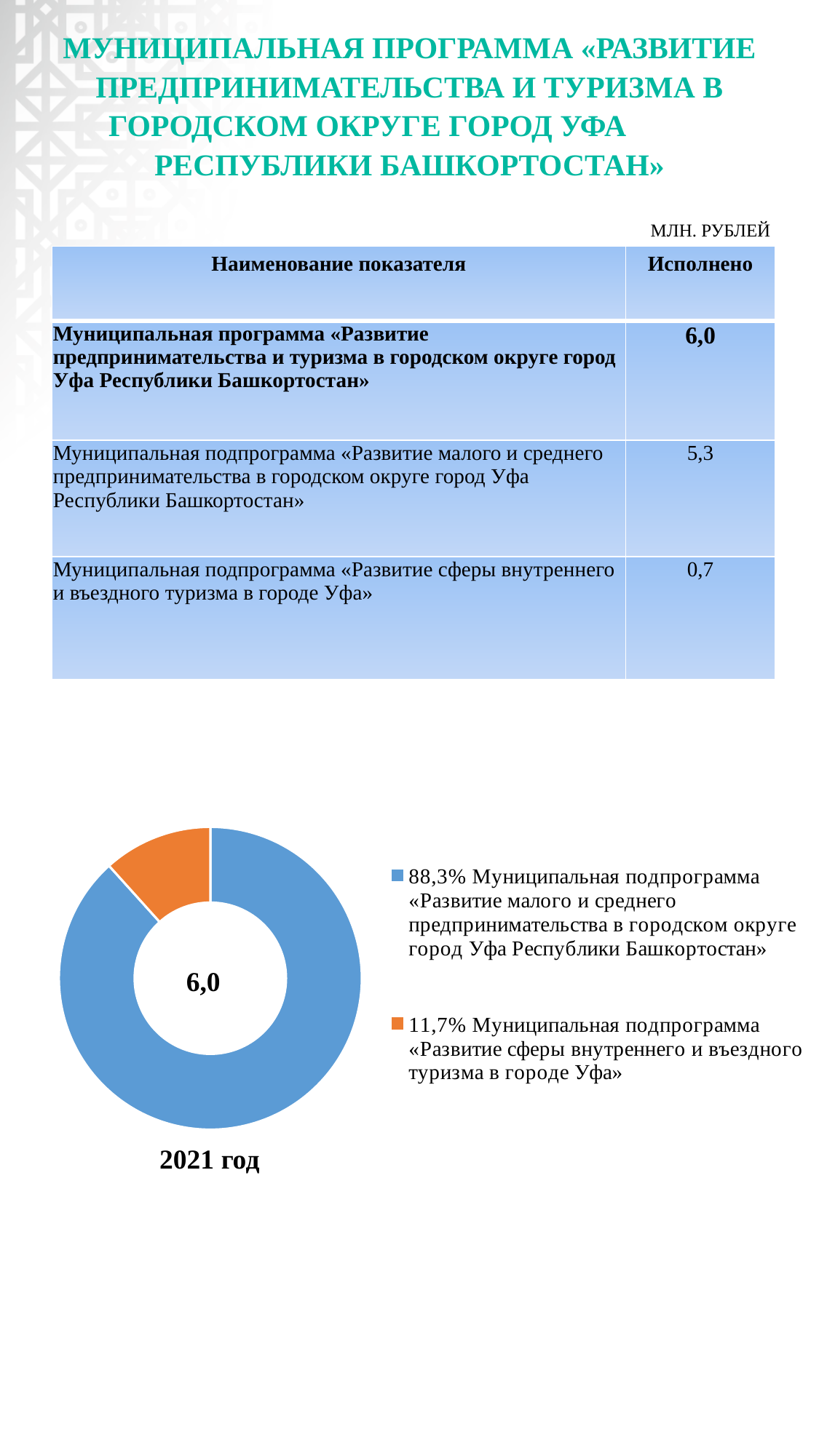
How many slices does the doughnut chart have? 2 What share of the doughnut chart does the subprogram «Развитие сферы внутреннего и въездного туризма в городе Уфа» represent? 11,7% What is the difference in percentage points between the two slices of the doughnut chart? 76,6 What value is printed in the centre of the doughnut chart? 6,0 What colour is the slice for the tourism subprogram in the doughnut chart? orange What year is labelled below the doughnut chart? 2021 год What kind of chart is shown on the slide? doughnut chart Which slice of the doughnut chart is the largest? Муниципальная подпрограмма «Развитие малого и среднего предпринимательства в городском округе город Уфа Республики Башкортостан» Which is larger in the doughnut chart: the share for small and medium entrepreneurship or the share for tourism? small and medium entrepreneurship How many entries does the legend of the doughnut chart list? 2 Which slice of the doughnut chart is the smallest? Муниципальная подпрограмма «Развитие сферы внутреннего и въездного туризма в городе Уфа» What share of the doughnut chart does the subprogram «Развитие малого и среднего предпринимательства в городском округе город Уфа Республики Башкортостан» represent? 88,3%